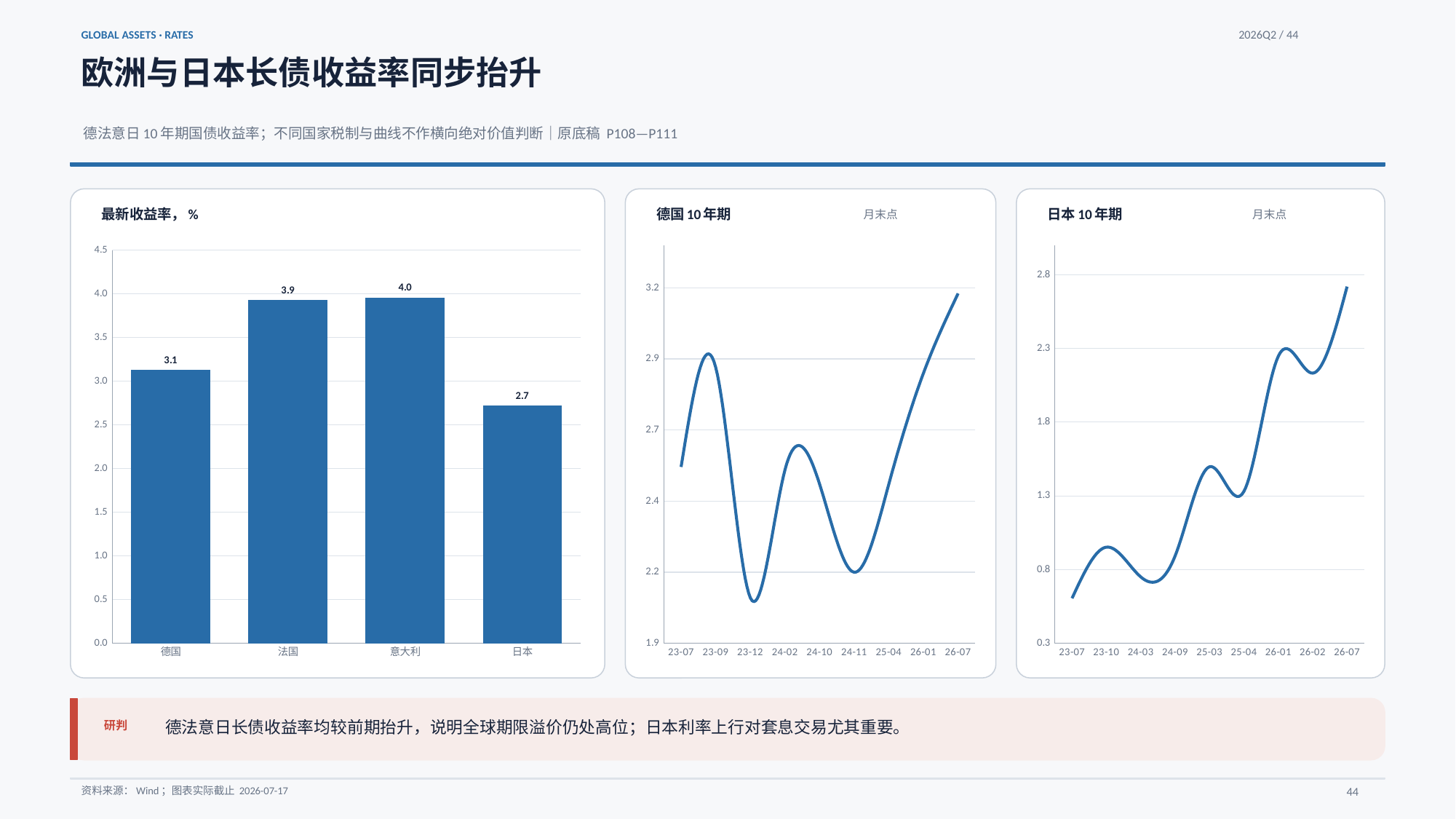
In the chart titled 最新收益率，%, what is the difference between the values for 法国 and 德国? 0.8 In the chart titled 德国 10 年期, is the value at 23-12 greater or less than 2.2? less What kind of chart is the one titled 最新收益率，%? bar chart In the chart titled 最新收益率，%, which category has the lowest value? 日本 In the chart titled 最新收益率，%, what is the value for 法国? 3.9 In the chart titled 最新收益率，%, which is larger, the value for 德国 or the value for 日本? 德国 In the chart titled 日本 10 年期, do the values generally rise or fall from 23-07 to 26-07? rise In the chart titled 日本 10 年期, how many x-axis points are labelled? 9 In the chart titled 最新收益率，%, which category has the highest value? 意大利 What kind of chart is the one titled 德国 10 年期? line chart In the chart titled 最新收益率，%, what is the value for 日本? 2.7 In the chart titled 最新收益率，%, how many categories are shown? 4